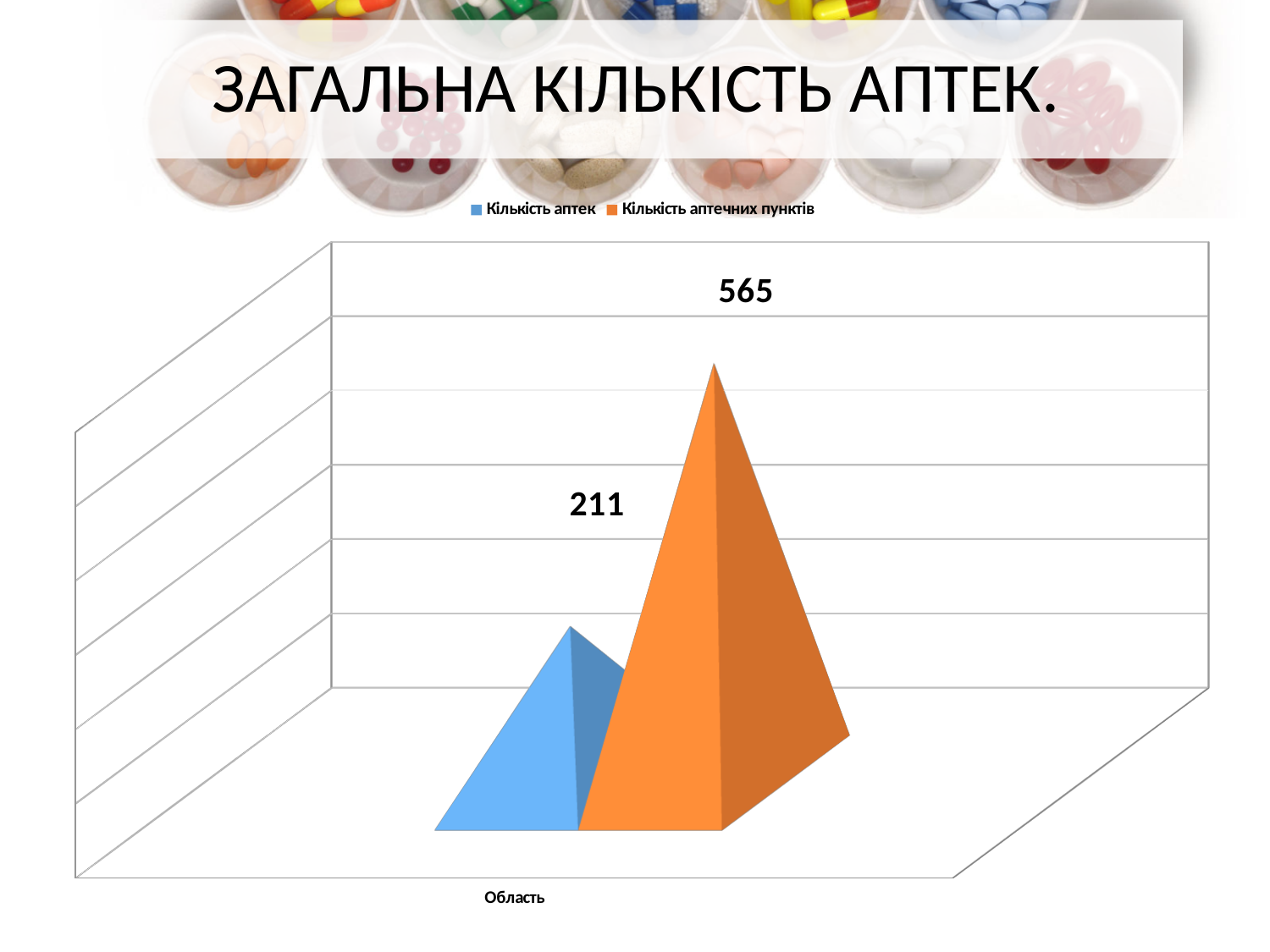
How many series does the legend list? 2 Which series has the highest value? Кількість аптечних пунктів What colour represents Кількість аптечних пунктів in the chart? Orange How many categories are shown on the x axis? 1 Which series has the lowest value? Кількість аптек What is the category label shown on the x axis? Область What is the title of the slide? ЗАГАЛЬНА КІЛЬКІСТЬ АПТЕК. What is the value for Кількість аптек? 211 What kind of chart is shown on the slide? Bar chart What is the value for Кількість аптечних пунктів? 565 What is the difference between the value for Кількість аптечних пунктів and the value for Кількість аптек? 354 Which series has the higher value, Кількість аптек or Кількість аптечних пунктів? Кількість аптечних пунктів